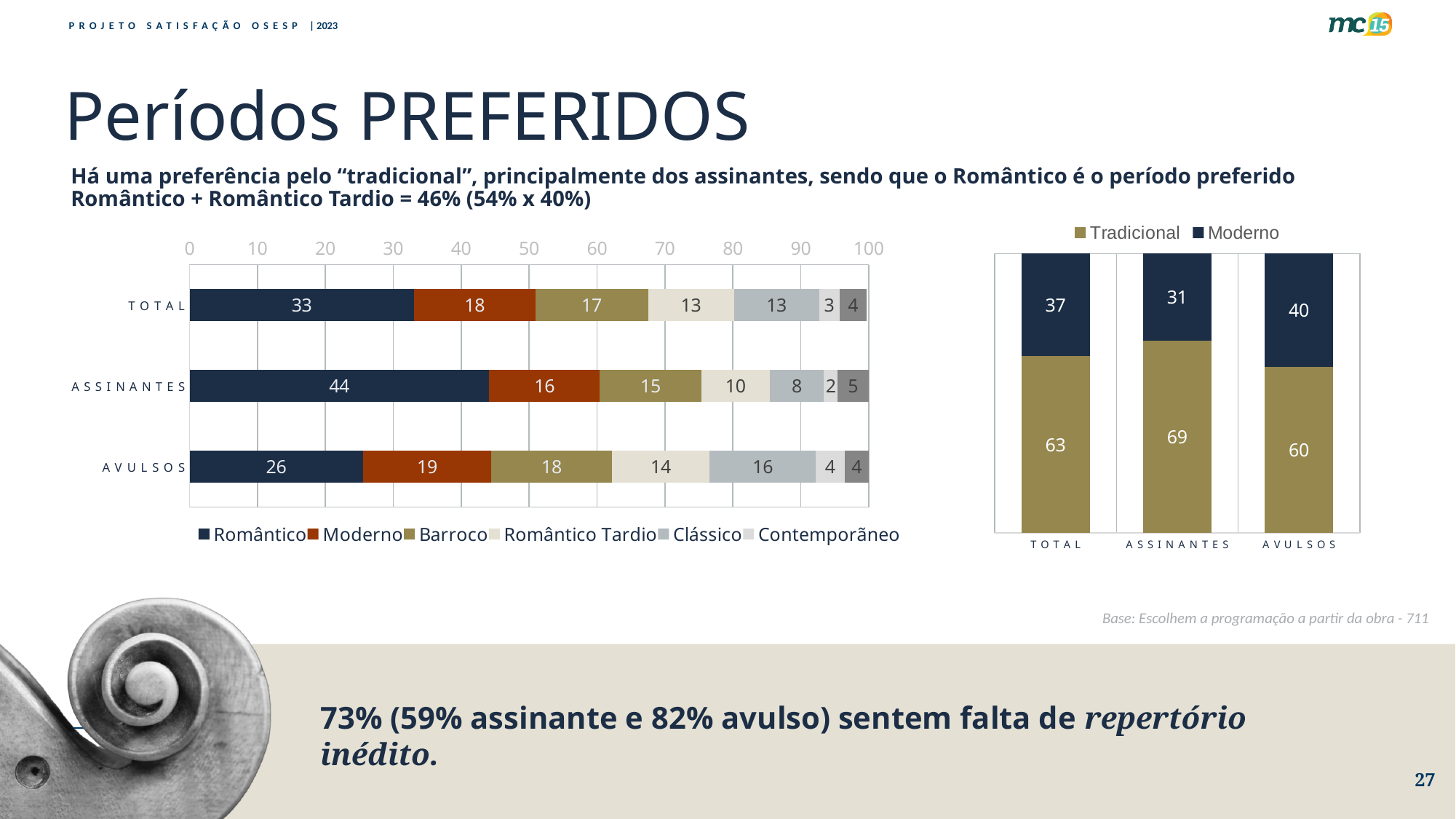
How many series does the legend of the left chart list? 6 In the left chart, what is the difference between the Romântico values for ASSINANTES and AVULSOS? 18 In the right chart, what is the Tradicional value for ASSINANTES? 69 In the left chart, which category has the lowest Barroco value? ASSINANTES In the left chart, what is the Romântico value for ASSINANTES? 44 In the left chart, what is the Clássico value for AVULSOS? 16 What kind of chart is the left chart? Stacked bar chart In the right chart, which category has the highest Moderno value? AVULSOS How many categories are shown on the x axis of the right chart? 3 In the right chart, what is the total of the stacked bar for TOTAL? 100 In the left chart, which category has the highest Romântico value? ASSINANTES In the left chart, which is larger for TOTAL: Moderno or Barroco? Moderno